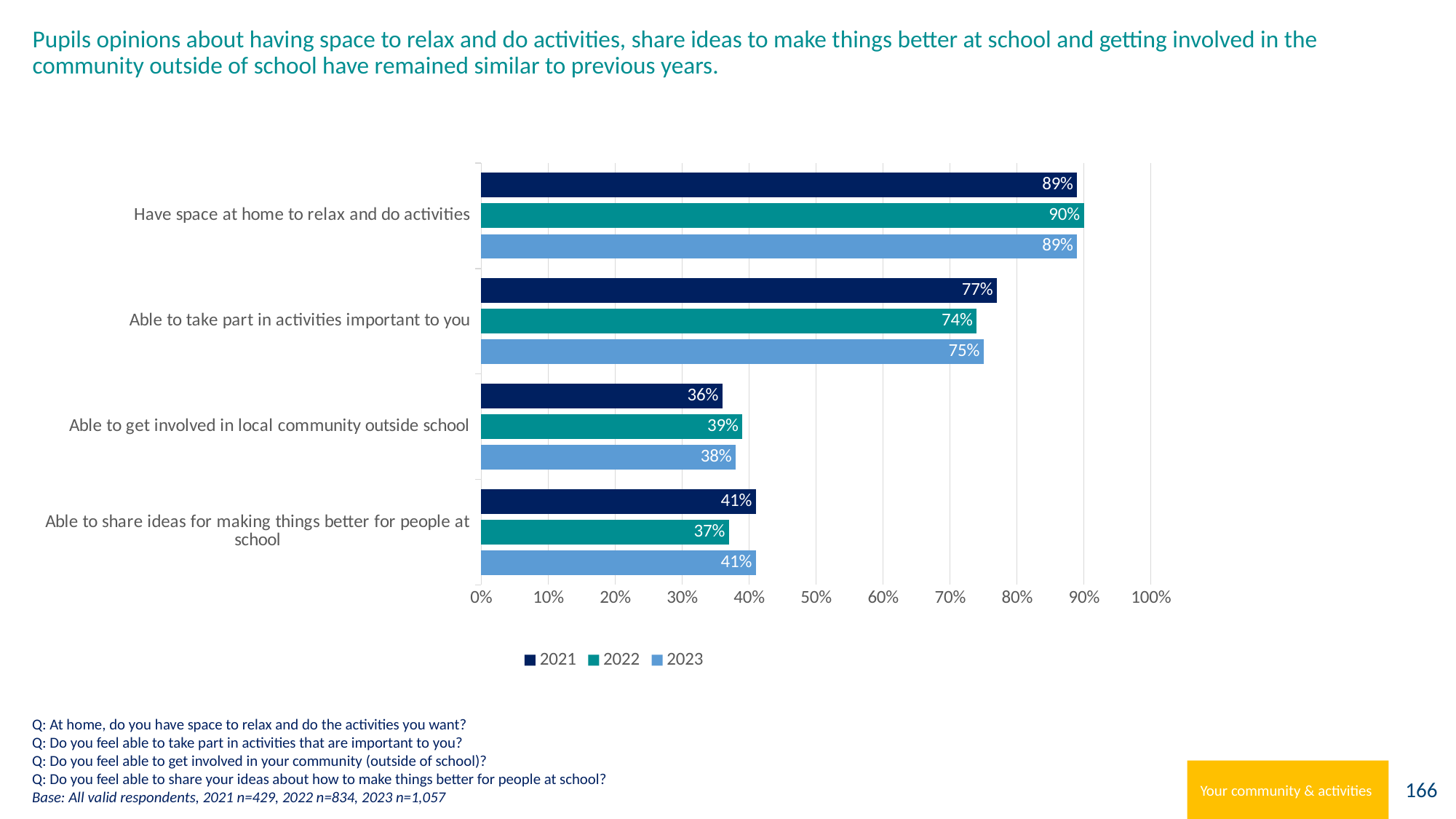
What is the difference between the 2021 and 2022 values for 'Able to take part in activities important to you'? 3 percentage points What is the 2022 value for 'Able to share ideas for making things better for people at school'? 37% Which years are listed in the chart legend? 2021, 2022, 2023 For 'Able to share ideas for making things better for people at school', is the 2021 value or the 2022 value larger? 2021 Which category has the lowest value in 2021? Able to get involved in local community outside school How many categories are shown on the chart? 4 What percentage of pupils in 2022 said they have space at home to relax and do activities? 90% How many series does the legend list? 3 What is the 2023 value for 'Able to take part in activities important to you'? 75% What is the 2021 value for 'Able to get involved in local community outside school'? 36% Which category has the highest value in 2023? Have space at home to relax and do activities What type of chart is shown on the slide? Bar chart